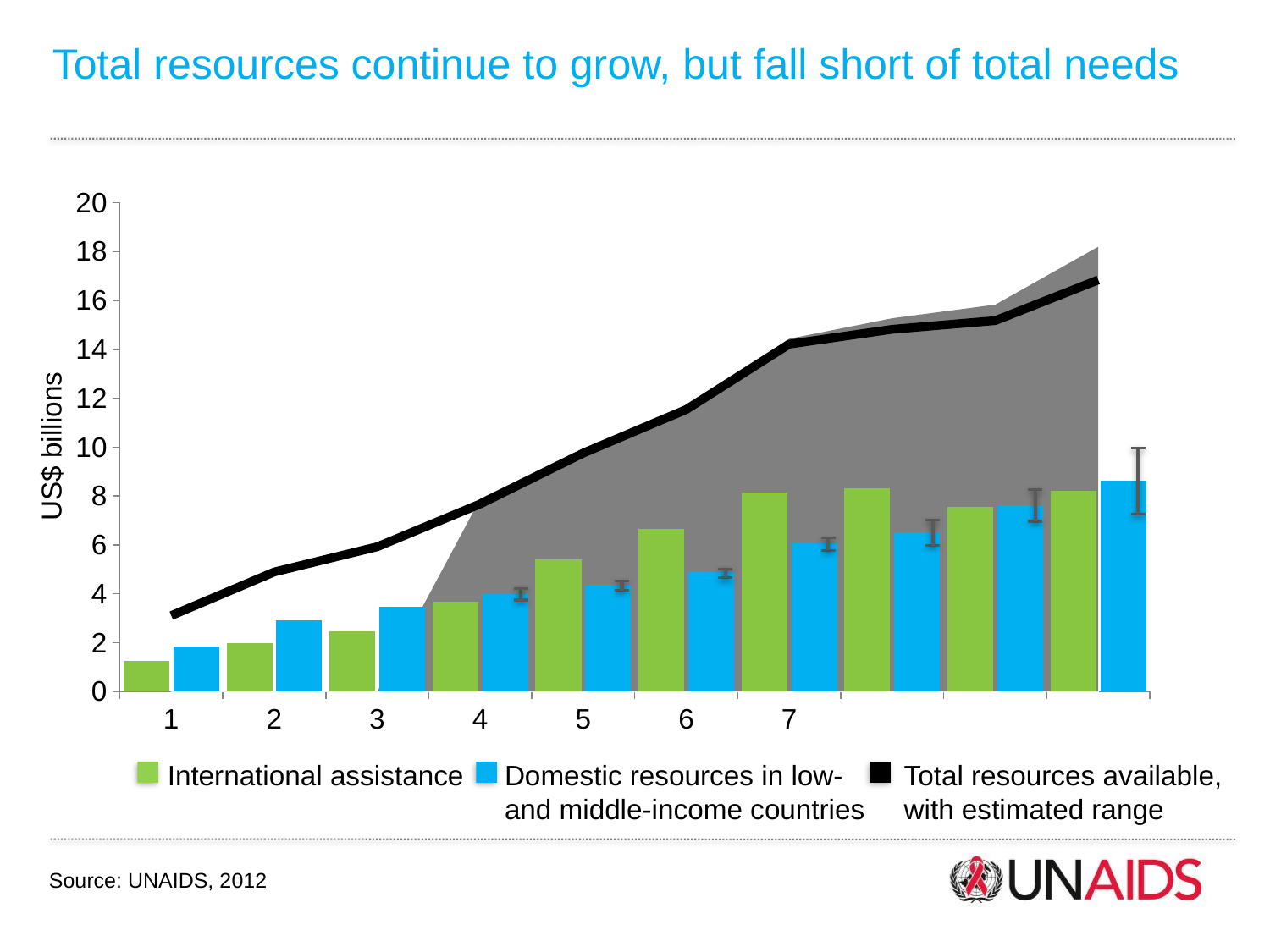
At category 6, which is larger: International assistance or Domestic resources in low- and middle-income countries? International assistance What kind of chart is used to show International assistance and Domestic resources? bar chart Which colour represents International assistance in the legend? green Is the value for Total resources available at category 7 greater or less than 12? greater What is the y-axis title of the chart? US$ billions At category 1, which is larger: International assistance or Domestic resources in low- and middle-income countries? Domestic resources in low- and middle-income countries Is the value for International assistance at category 4 greater or less than 4? less Is the value for International assistance at category 6 greater or less than 6? greater Which labelled category has the lowest value for International assistance? 1 How many series does the legend list? 3 Does the Total resources available line rise or fall along the x axis? rise